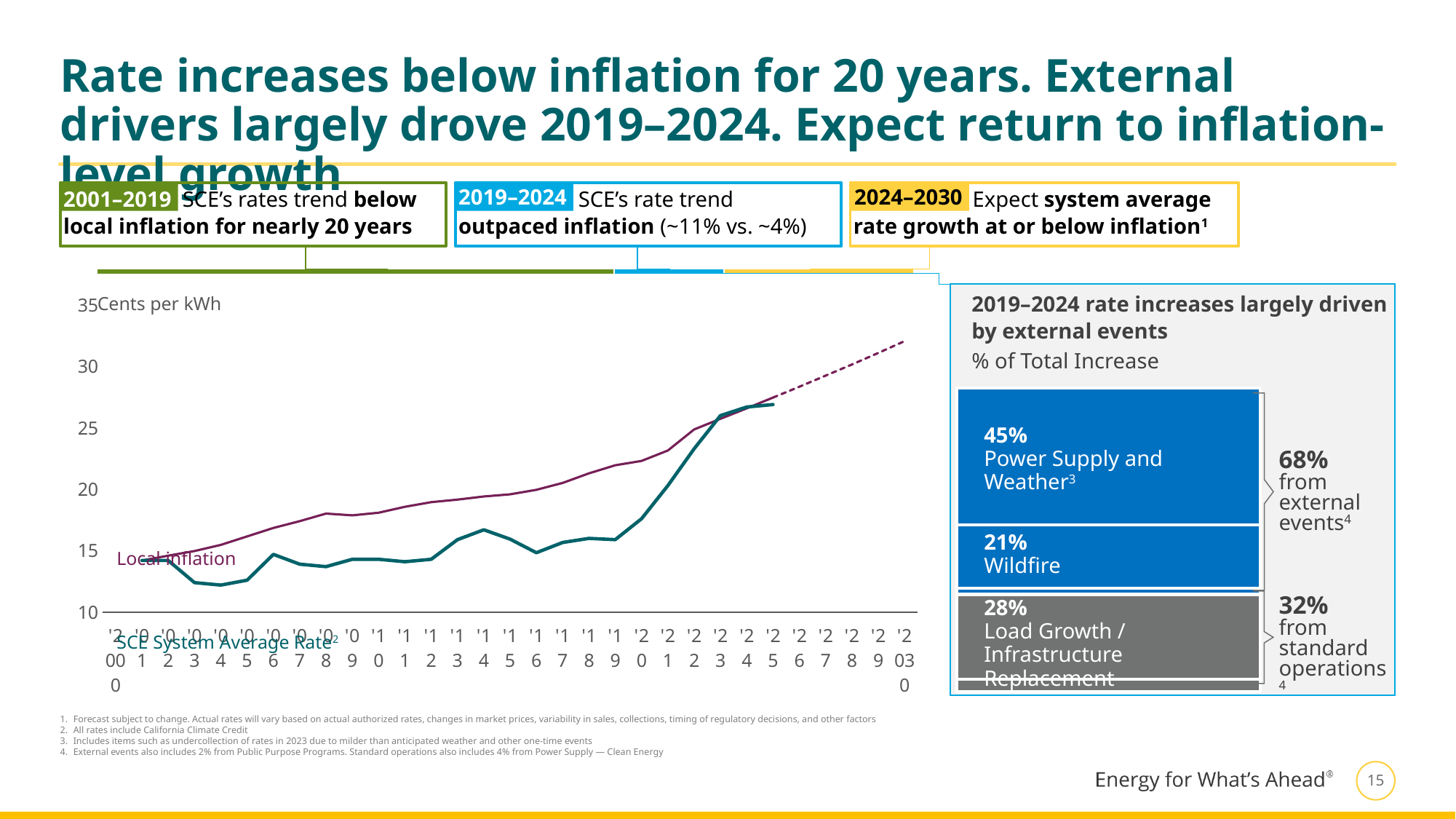
In the right chart '% of Total Increase', what share is attributed to Wildfire? 21% In the left line chart, is the SCE System Average Rate for '03 greater or less than 15? less In the left line chart, is the SCE System Average Rate for '25 greater or less than 25? greater In the right chart '% of Total Increase', what share is attributed to Power Supply and Weather? 45% In the left line chart, is the Local inflation value for '20 greater or less than 20? greater In the left line chart, what unit is shown on the y axis? Cents per kWh In the left line chart, which is higher in '15: Local inflation or SCE System Average Rate? Local inflation What kind of chart is the left chart showing SCE System Average Rate and Local inflation? line chart In the right chart '% of Total Increase', which category has the smallest share? Wildfire In the left line chart, how many series are plotted? 3 In the right chart '% of Total Increase', what is the difference between the share from external events and the share from standard operations? 36 percentage points In the left line chart, does the SCE System Average Rate rise or fall from '19 to '24? rise